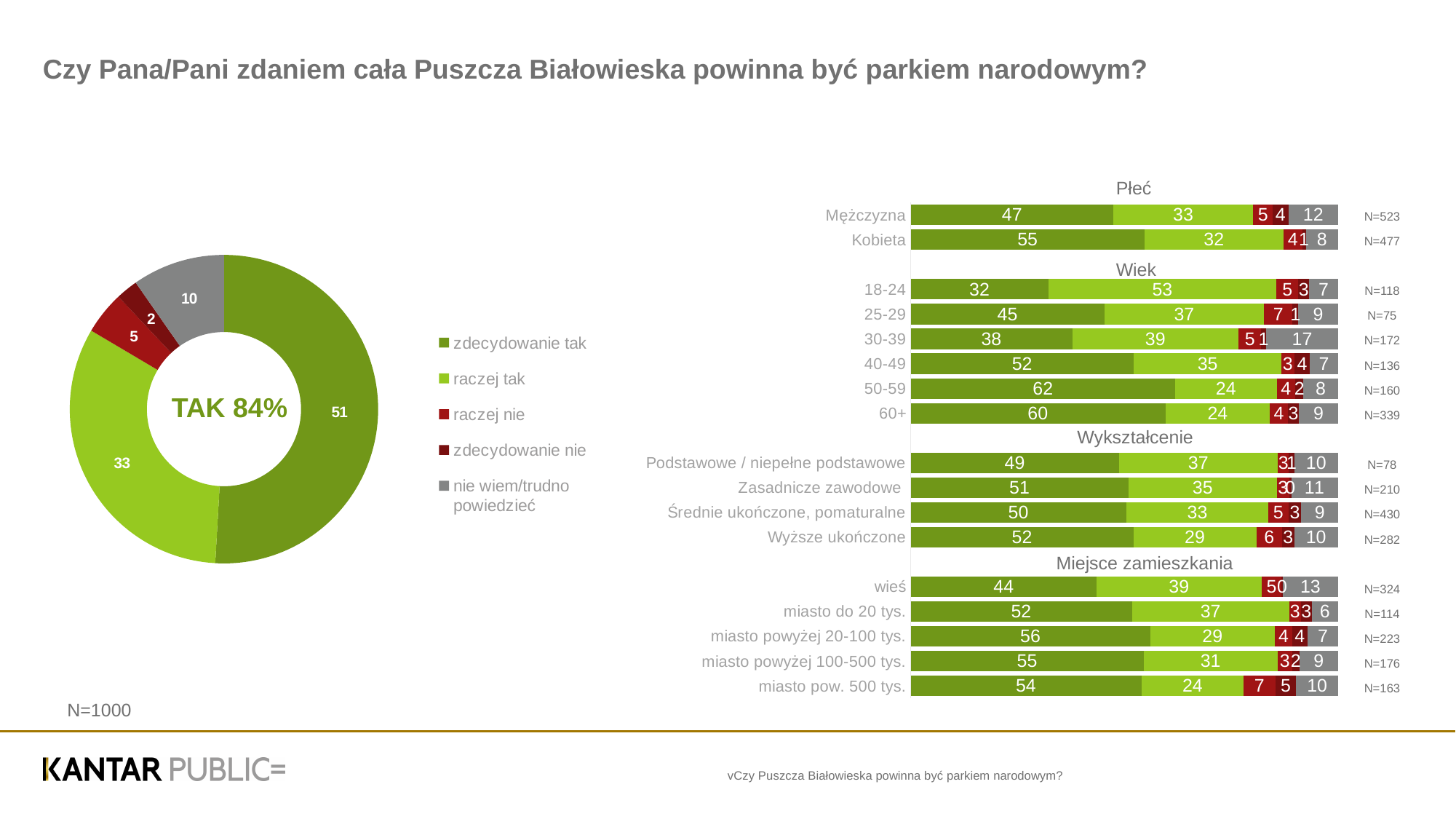
In the donut chart on the left, what is the combined "TAK" share shown in the centre? TAK 84% In the donut chart on the left, what is the value for "nie wiem/trudno powiedzieć"? 10 In the donut chart on the left, which answer category has the smallest share? zdecydowanie nie In the bar chart on the right, what is the difference between the "zdecydowanie tak" values for Kobieta and Mężczyzna? 8 In the bar chart on the right, which age group has the lowest "zdecydowanie tak" value? 18-24 In the donut chart on the left, what percentage of respondents answered "zdecydowanie tak"? 51 How many entries does the legend of the donut chart on the left list? 5 What kind of chart is the chart on the right side of the slide? stacked bar chart In the bar chart on the right, which has a larger "nie wiem/trudno powiedzieć" value: 30-39 or 40-49? 30-39 In the bar chart on the right, what is the "zdecydowanie tak" value for Kobieta? 55 In the bar chart on the right, which age group has the highest "zdecydowanie tak" value? 50-59 In the bar chart on the right, how many categories are shown under "Miejsce zamieszkania"? 5